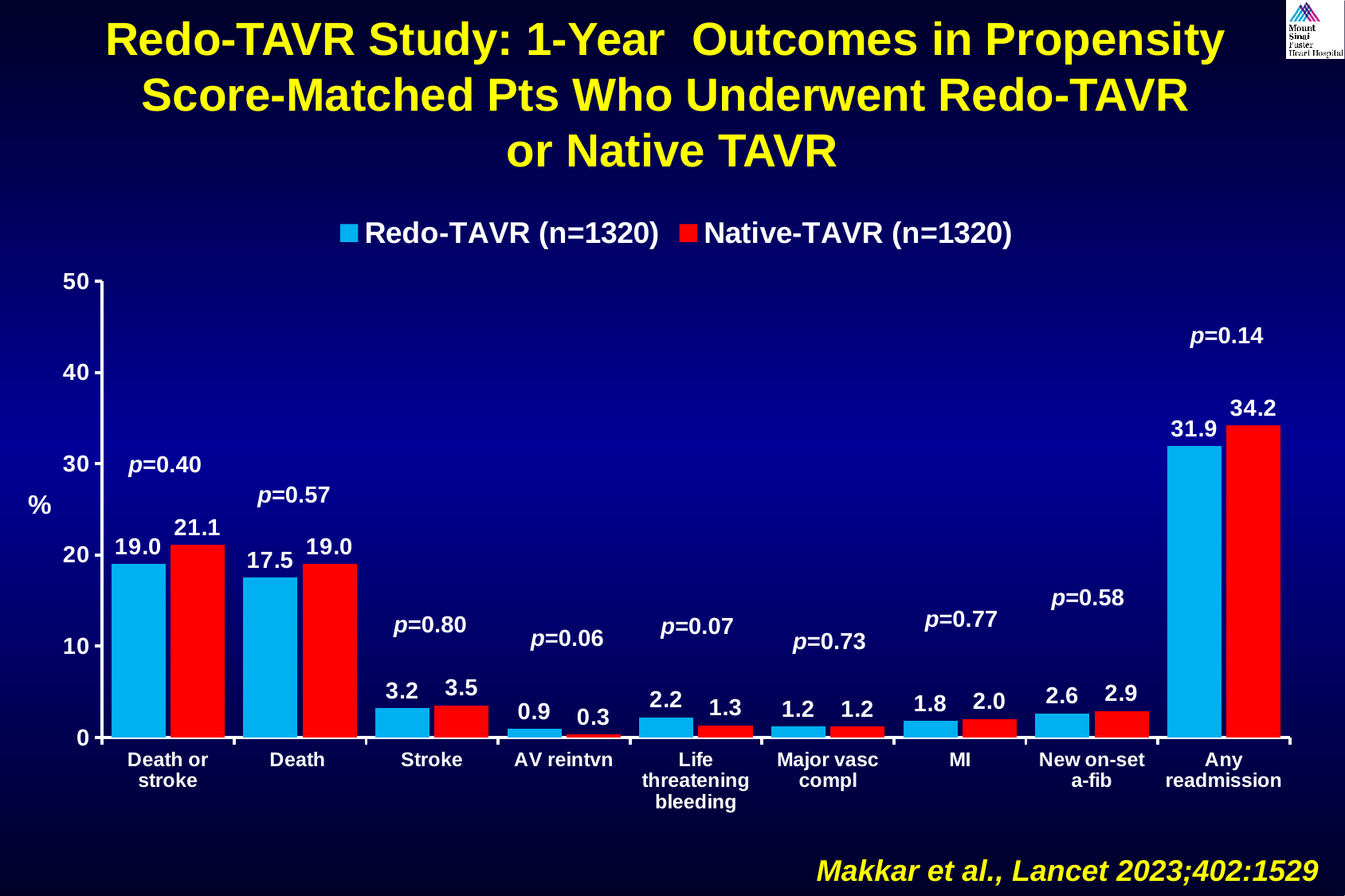
For Life threatening bleeding, which series has the larger value, Redo-TAVR or Native-TAVR? Redo-TAVR What is the difference between the Native-TAVR and Redo-TAVR values for Any readmission? 2.3 How many outcome categories are shown on the x axis? 9 What kind of chart is shown on the slide? Bar chart Which category has the highest Native-TAVR value? Any readmission What is the difference between the Native-TAVR and Redo-TAVR values for Death or stroke? 2.1 How many series does the legend list? 2 What p-value is shown above the Any readmission bars? p=0.14 Which category has the lowest Native-TAVR value? AV reintvn What is the Redo-TAVR value for Death or stroke? 19.0 What is the Redo-TAVR value for AV reintvn? 0.9 What is the Native-TAVR value for Any readmission? 34.2